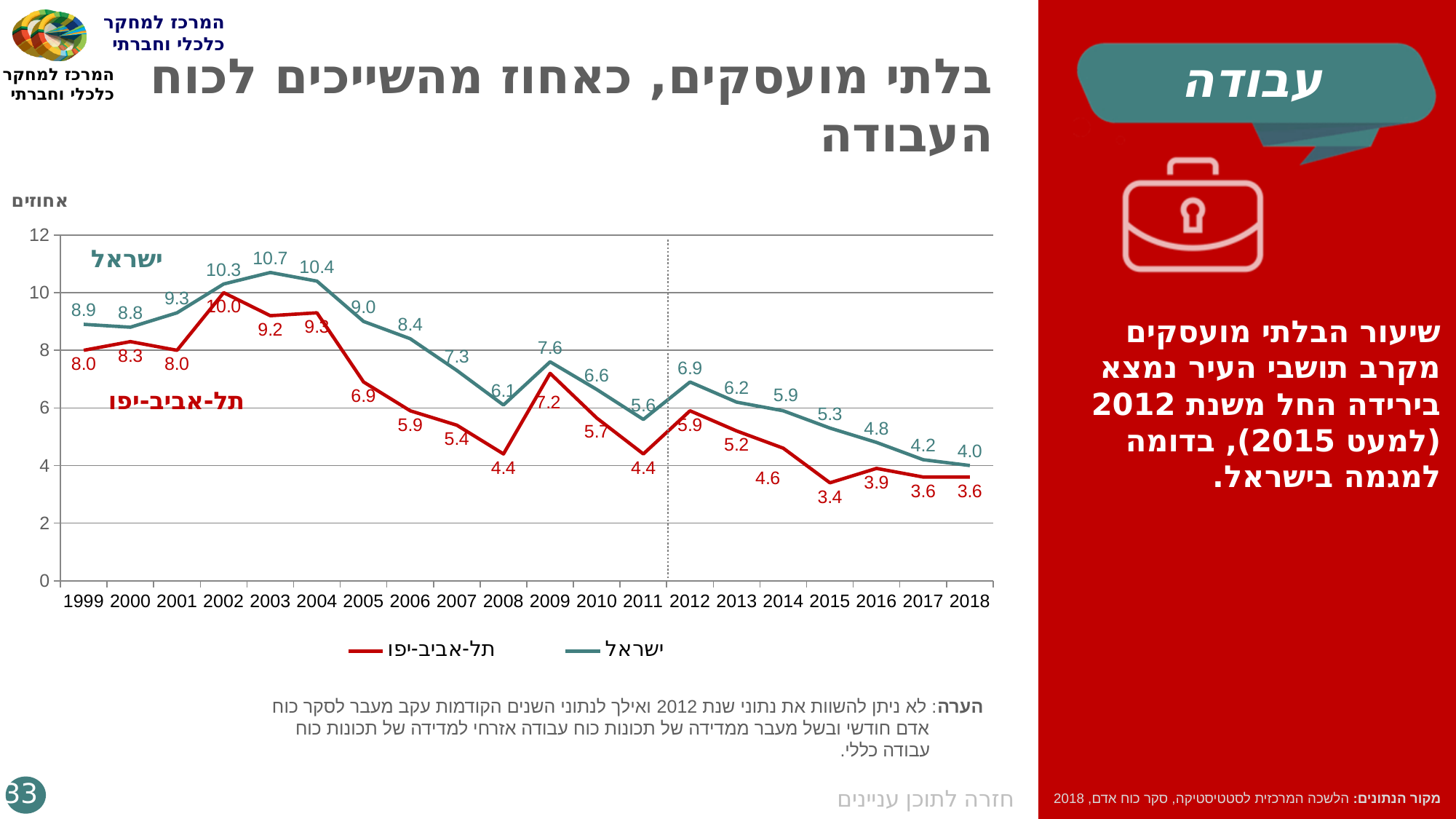
What is the value for תל-אביב-יפו in 2002? 10.0 In which year does the תל-אביב-יפו series reach its lowest value? 2015 What is the value for ישראל in 2003? 10.7 How many years are shown on the x axis? 20 How many series does the legend list? 2 What kind of chart is shown on the slide? line chart Does the ישראל series rise or fall from 2012 to 2018? fall In which year does the ישראל series reach its highest value? 2003 Is the value for ישראל in 2012 greater or less than 6? greater Which series has the higher value in 2008, ישראל or תל-אביב-יפו? ישראל What is the value for תל-אביב-יפו in 2015? 3.4 What is the difference between the ישראל and תל-אביב-יפו values in 2018? 0.4